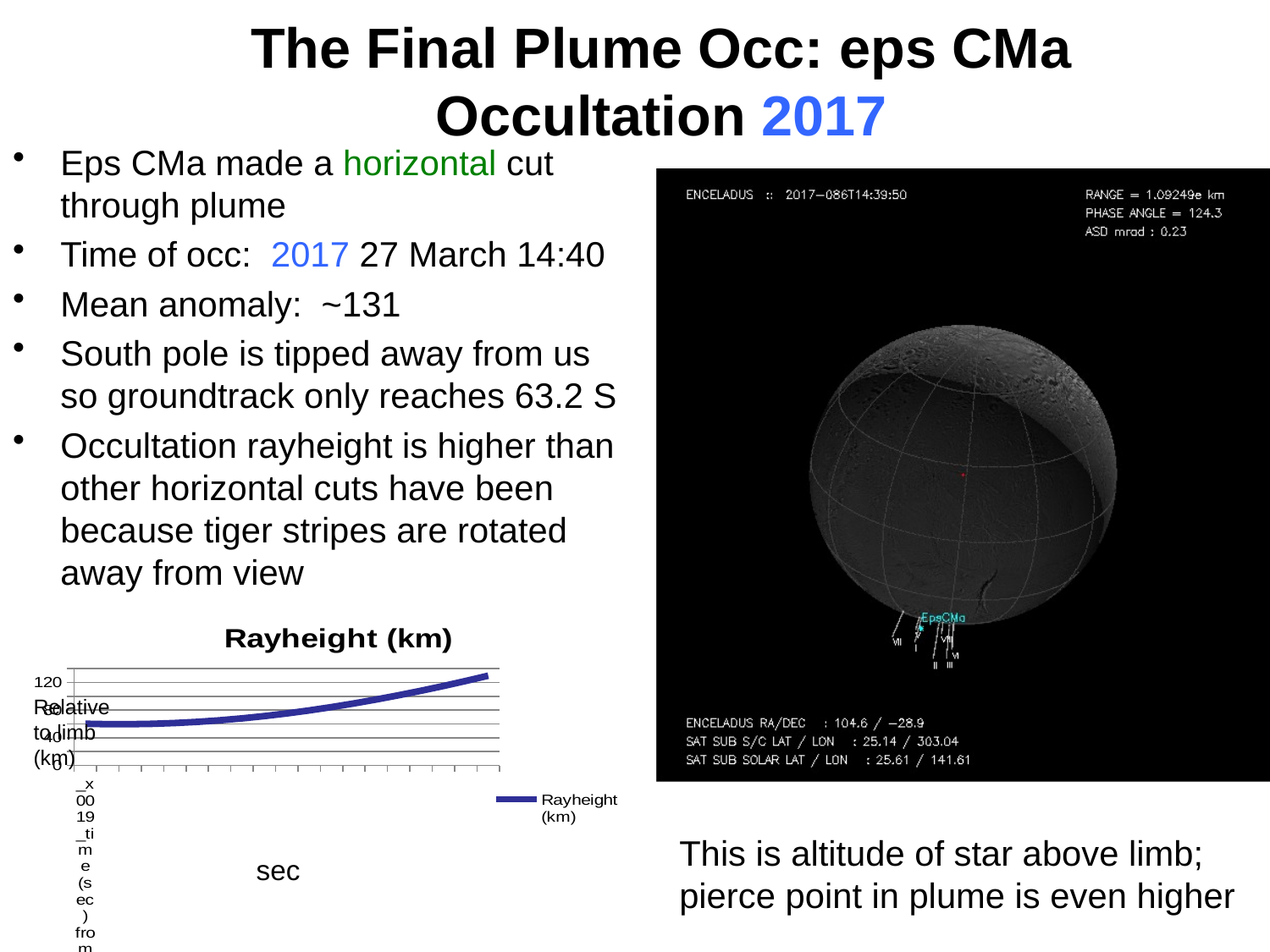
In the "Rayheight (km)" chart, is the value at the left end of the line greater or less than 0? greater What is the title of the chart on the slide? Rayheight (km) In the "Rayheight (km)" chart, do the values rise or fall along the x axis? rise How many series does the legend of the "Rayheight (km)" chart list? 1 In the "Rayheight (km)" chart, is the value at the left end of the line greater or less than 80? less What kind of chart is the "Rayheight (km)" chart on the slide? line chart What is the name of the series shown in the legend of the "Rayheight (km)" chart? Rayheight (km) In the "Rayheight (km)" chart, is the value at the right end of the line greater or less than 80? greater What is the highest tick value shown on the y axis of the "Rayheight (km)" chart? 120